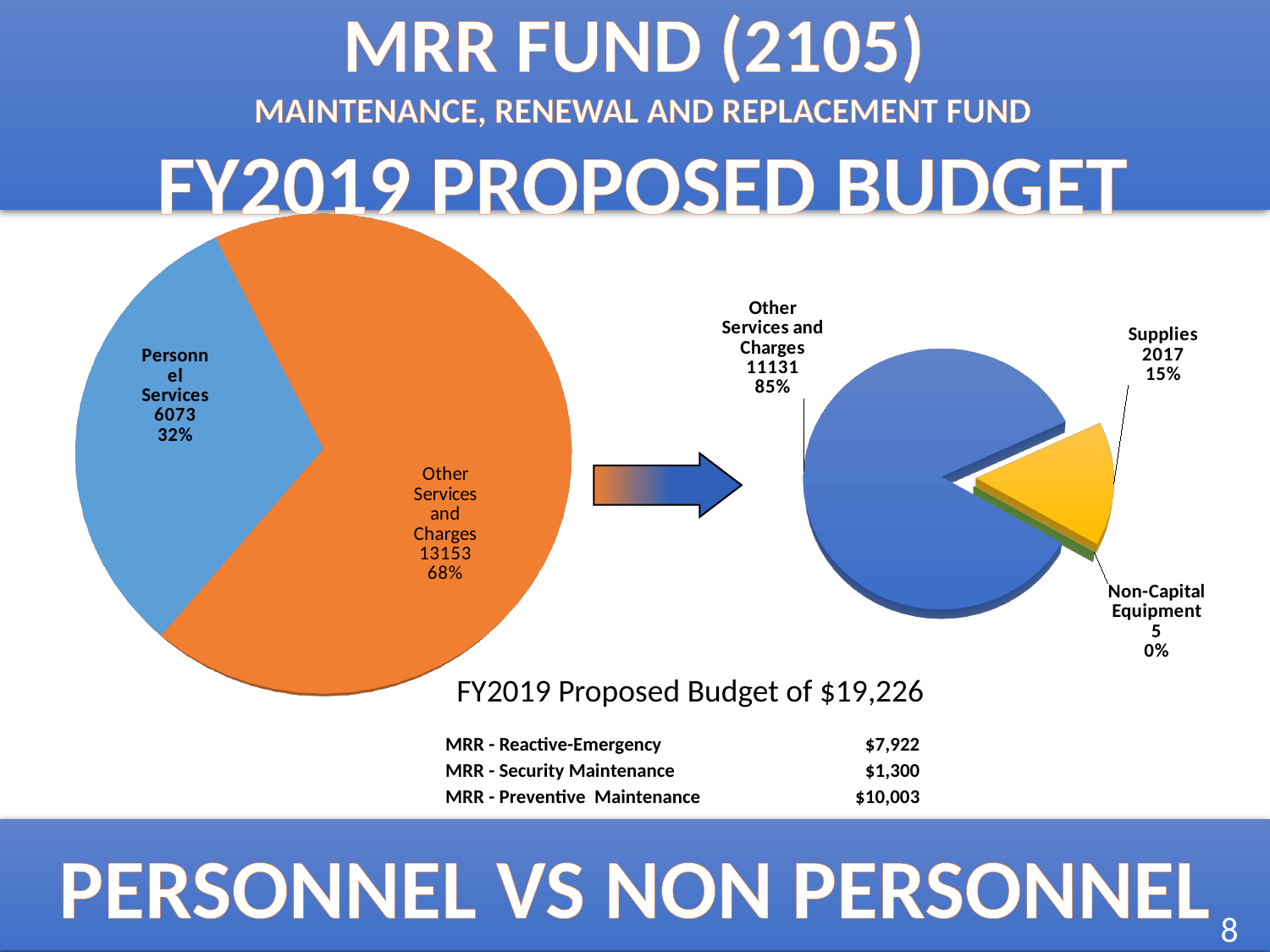
In the right pie chart, what value is shown for Supplies? 2017 In the right pie chart, which is larger, Supplies or Non-Capital Equipment? Supplies In the left pie chart, what is the difference between the Other Services and Charges value and the Personnel Services value? 7080 What type of chart is the left chart on the slide? Pie chart In the left pie chart, what percentage share does Other Services and Charges have? 68% In the right pie chart, which slice is the smallest? Non-Capital Equipment In the left pie chart, which slice is the largest? Other Services and Charges In the left pie chart, what value is shown for Personnel Services? 6073 In the left pie chart, what value is shown for Other Services and Charges? 13153 In the right pie chart, what value is shown for Non-Capital Equipment? 5 How many slices does the right pie chart have? 3 In the right pie chart, what percentage share does Other Services and Charges have? 85%